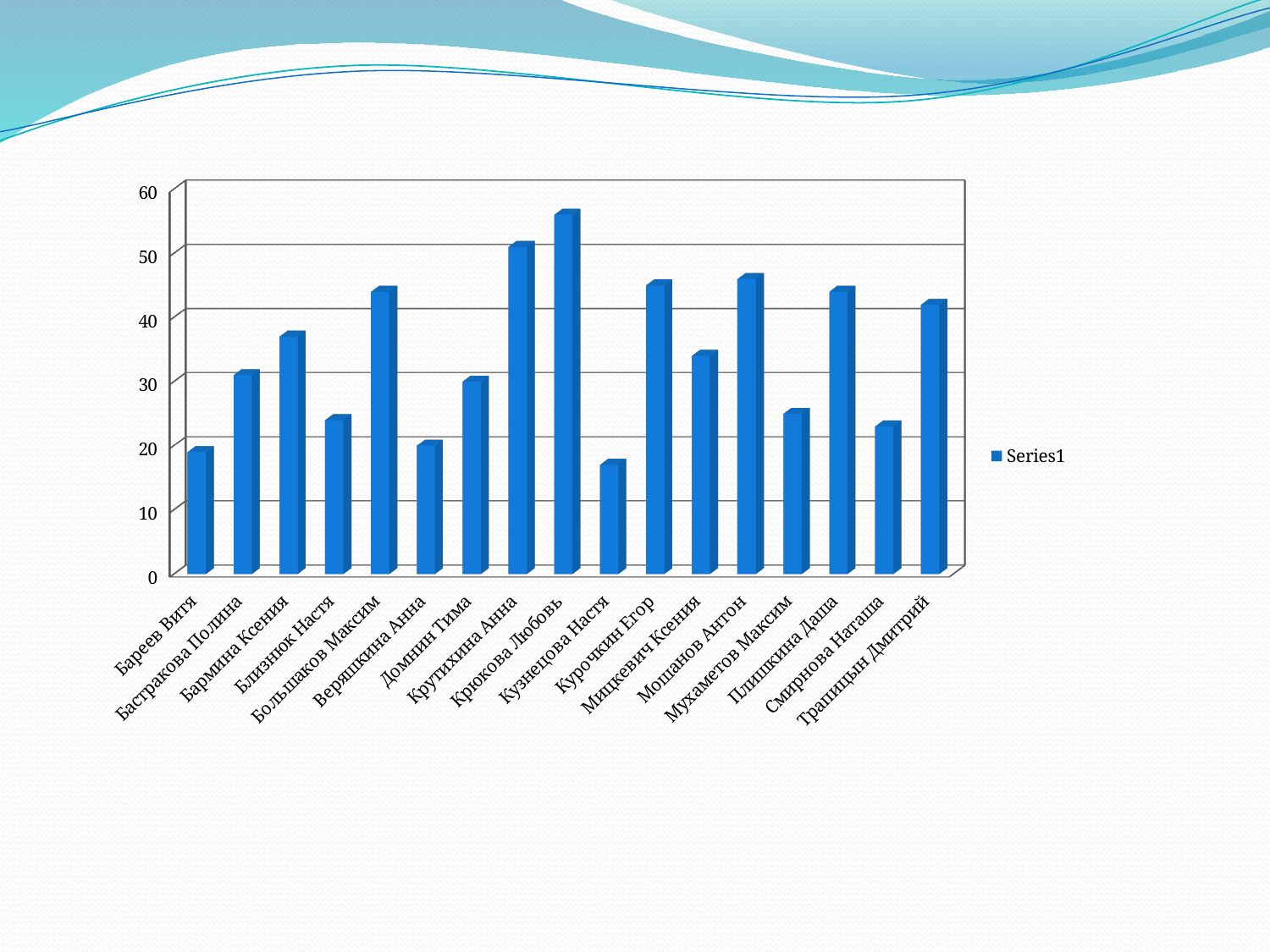
Is the value for Большаков Максим greater or less than 40? greater Which category has the highest bar in the chart? Крюкова Любовь Which is larger, the value for Мошанов Антон or the value for Мухаметов Максим? Мошанов Антон Is the value for Мухаметов Максим greater or less than 30? less Is the value for Кузнецова Настя greater or less than 20? less What kind of chart is shown on the slide? bar chart How many categories (names) are shown on the x axis of the chart? 17 Which is larger, the value for Крутихина Анна or the value for Бастракова Полина? Крутихина Анна How many series does the chart's legend list? 1 What is the name of the series shown in the chart's legend? Series1